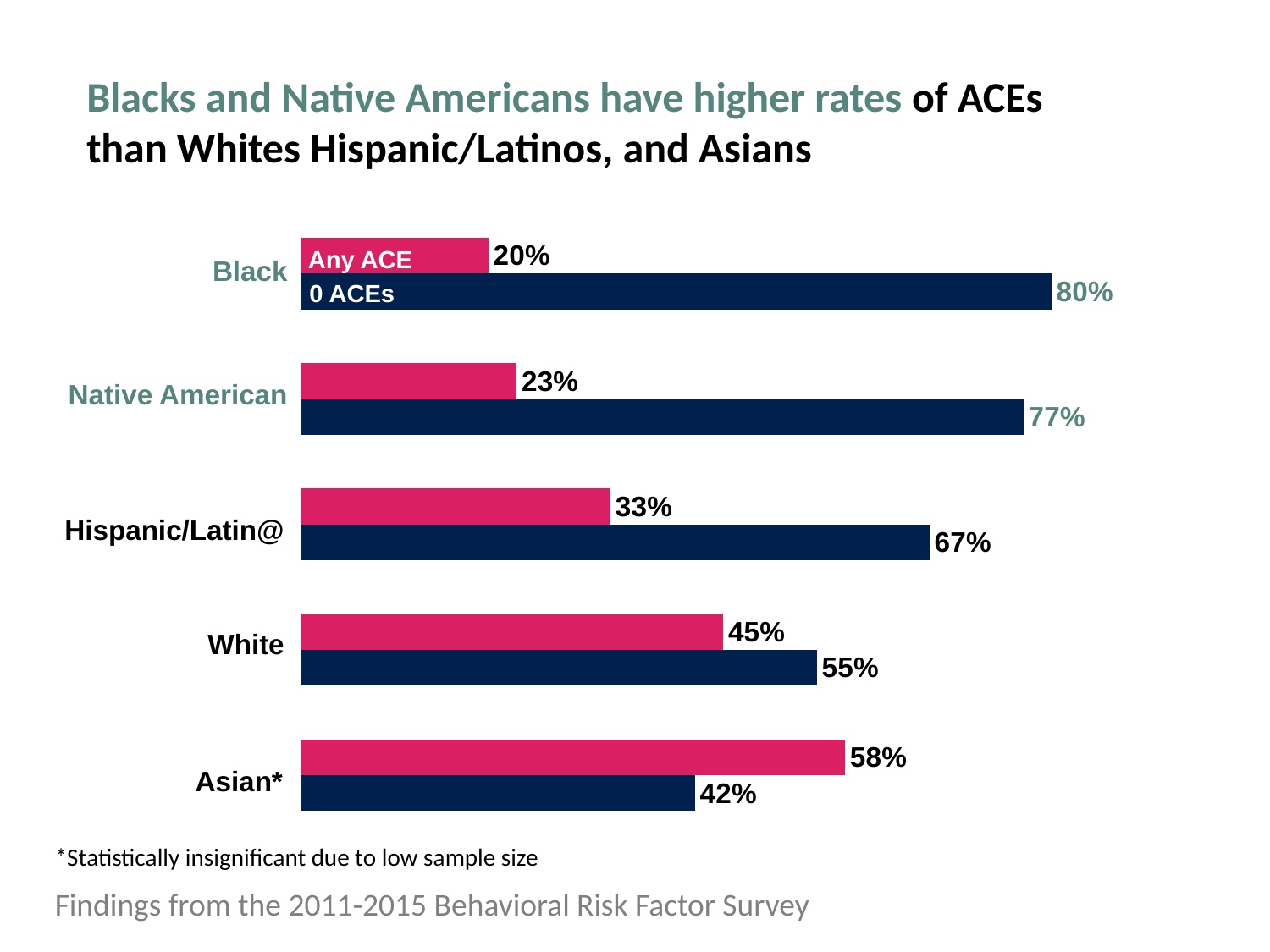
What is the '0 ACEs' value for White? 55% What is the '0 ACEs' value for Native American? 77% How many racial/ethnic groups are shown in the chart? 5 What is the 'Any ACE' value for Hispanic/Latin@? 33% How many series does the chart show? 2 Which is larger for White: the 'Any ACE' value or the '0 ACEs' value? 0 ACEs Which group has the highest 'Any ACE' value? Asian* What is the difference between the '0 ACEs' and 'Any ACE' values for Black? 60% What is the 'Any ACE' value for Black? 20% What does the asterisk next to Asian indicate, according to the footnote? Statistically insignificant due to low sample size What kind of chart is shown on the slide? bar chart Which group has the lowest '0 ACEs' value? Asian*